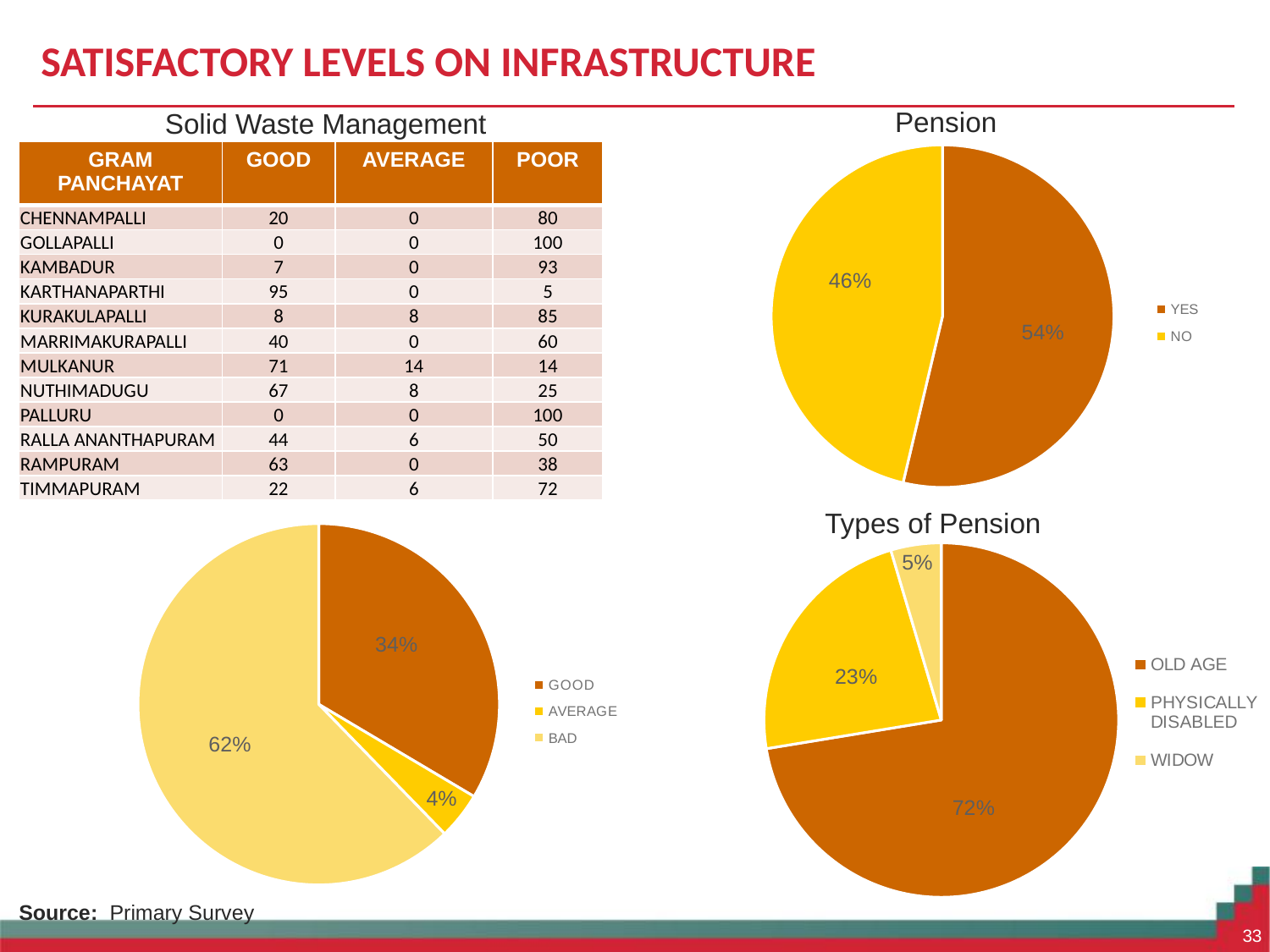
What kind of chart is the Pension chart? Pie chart In the Pension pie chart, what is the difference between the YES and NO shares? 8% In the bottom-left pie chart, which category has the largest share? BAD In the bottom-left pie chart, what share is labelled AVERAGE? 4% In the Pension pie chart, which slice is larger, YES or NO? YES In the Types of Pension pie chart, which category has the smallest share? WIDOW In the Pension pie chart, what share is labelled NO? 46% In the bottom-left pie chart, what share is labelled BAD? 62% How many categories does the legend of the Types of Pension pie chart list? 3 In the Types of Pension pie chart, what share is PHYSICALLY DISABLED? 23% In the Pension pie chart, what share is labelled YES? 54% In the Types of Pension pie chart, what share is OLD AGE? 72%